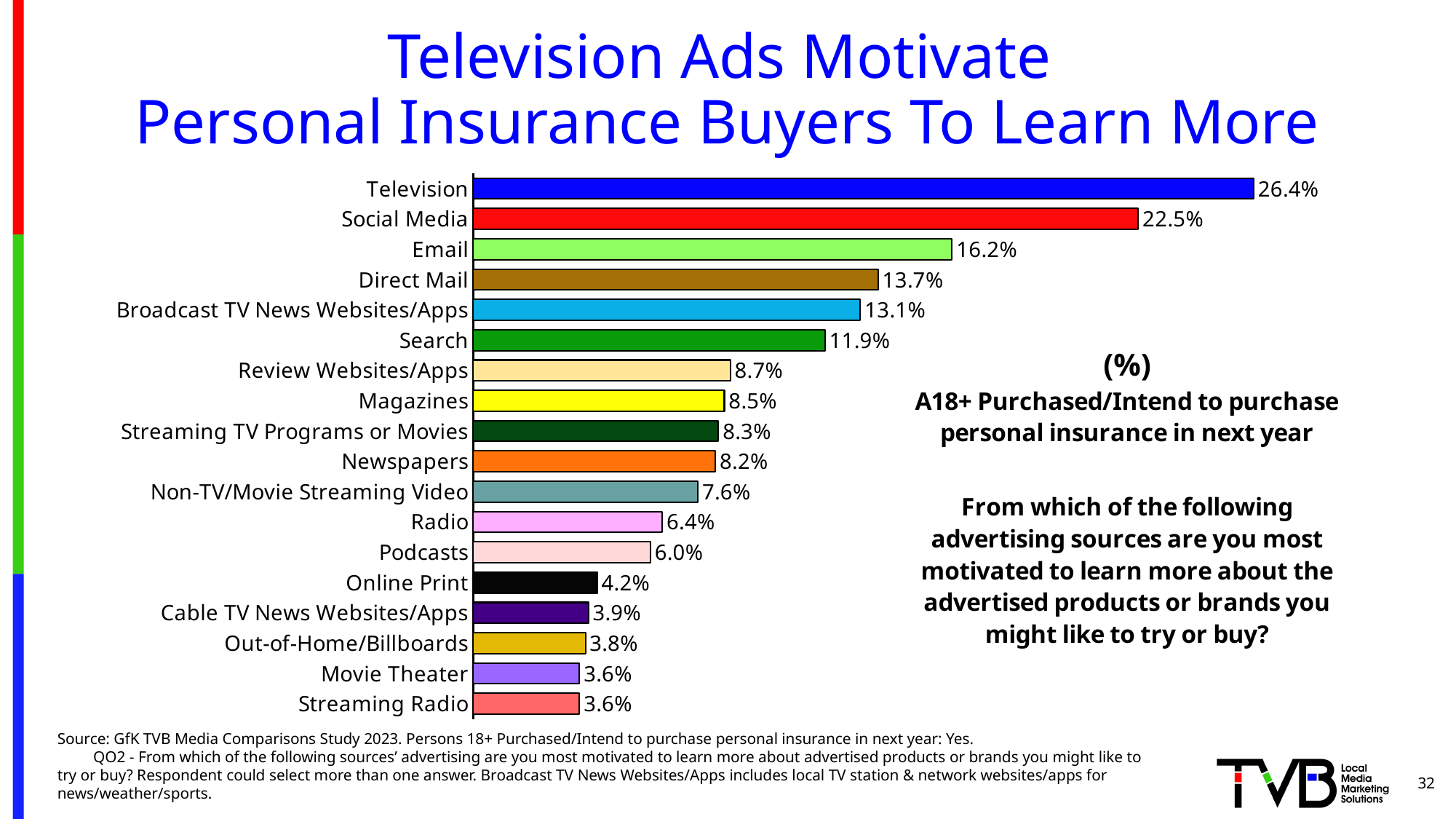
How many categories are shown in the chart? 18 What is the difference between the values for Email and Search? 4.3% Which is larger, the value for Radio or the value for Online Print? Radio What is the value for Television? 26.4% What is the difference between the values for Television and Social Media? 3.9% Which is larger, the value for Broadcast TV News Websites/Apps or the value for Cable TV News Websites/Apps? Broadcast TV News Websites/Apps Which category has the highest value? Television What colour is the bar for Social Media? Red What is the value for Streaming TV Programs or Movies? 8.3% What kind of chart is shown on the slide? Bar chart What is the value for Direct Mail? 13.7% What is the value for Podcasts? 6.0%